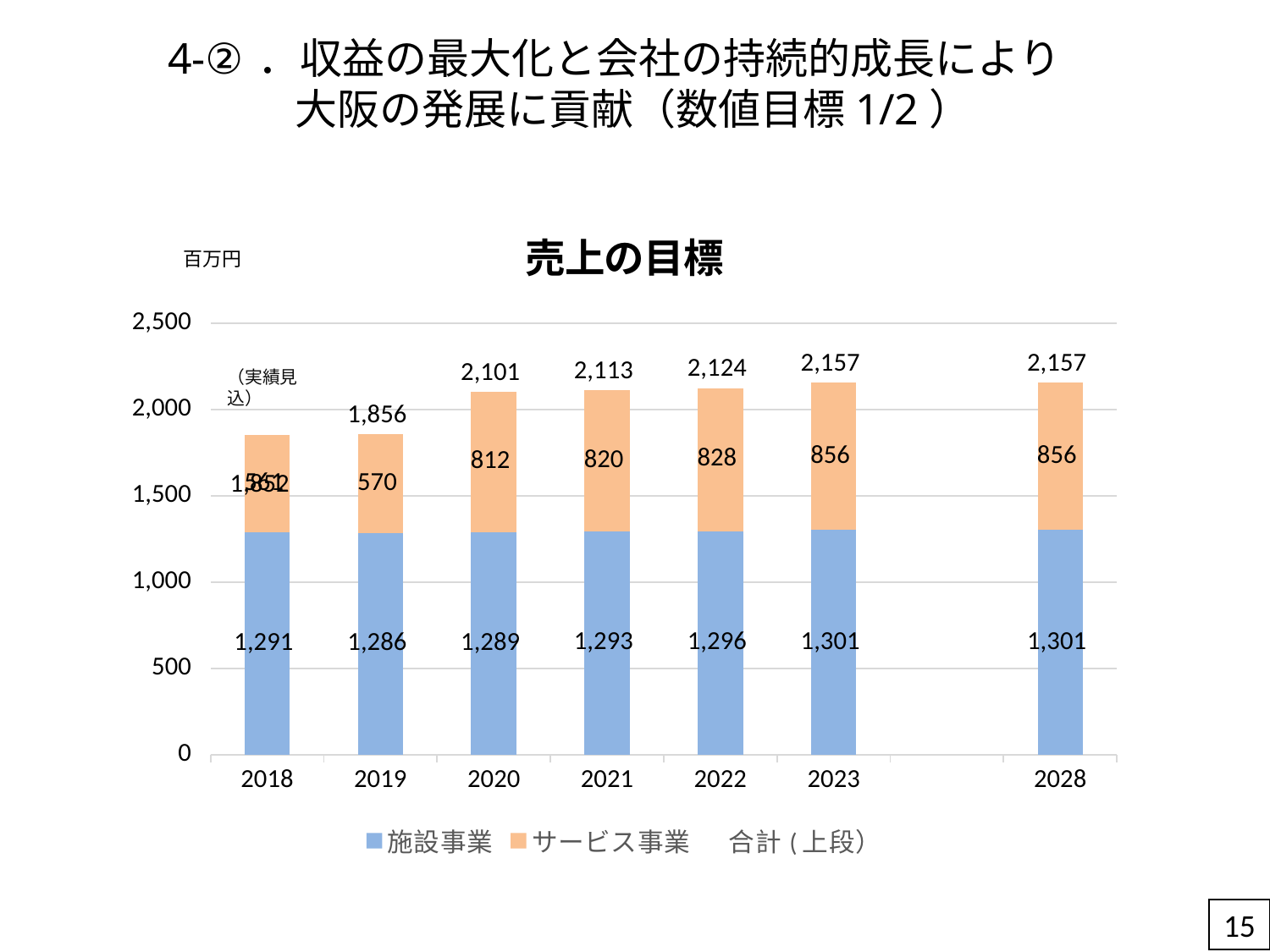
How many years are shown on the x axis of the chart? 7 What is the difference between the サービス事業 values for 2023 and 2020? 44 What type of chart is shown on the slide? stacked bar chart What is the total (合計) shown above the bar for 2022? 2,124 What is the value of サービス事業 for 2021? 820 Which is larger, the 施設事業 value for 2022 or for 2019? 2022 What is the value of 施設事業 for 2020? 1,289 Is the total for 2023 greater or less than 2,000? greater What is the value of サービス事業 for 2019? 570 Which year has the lowest total among 2019 through 2028? 2019 What is the value of 施設事業 for 2028? 1,301 What is the title of the chart? 売上の目標